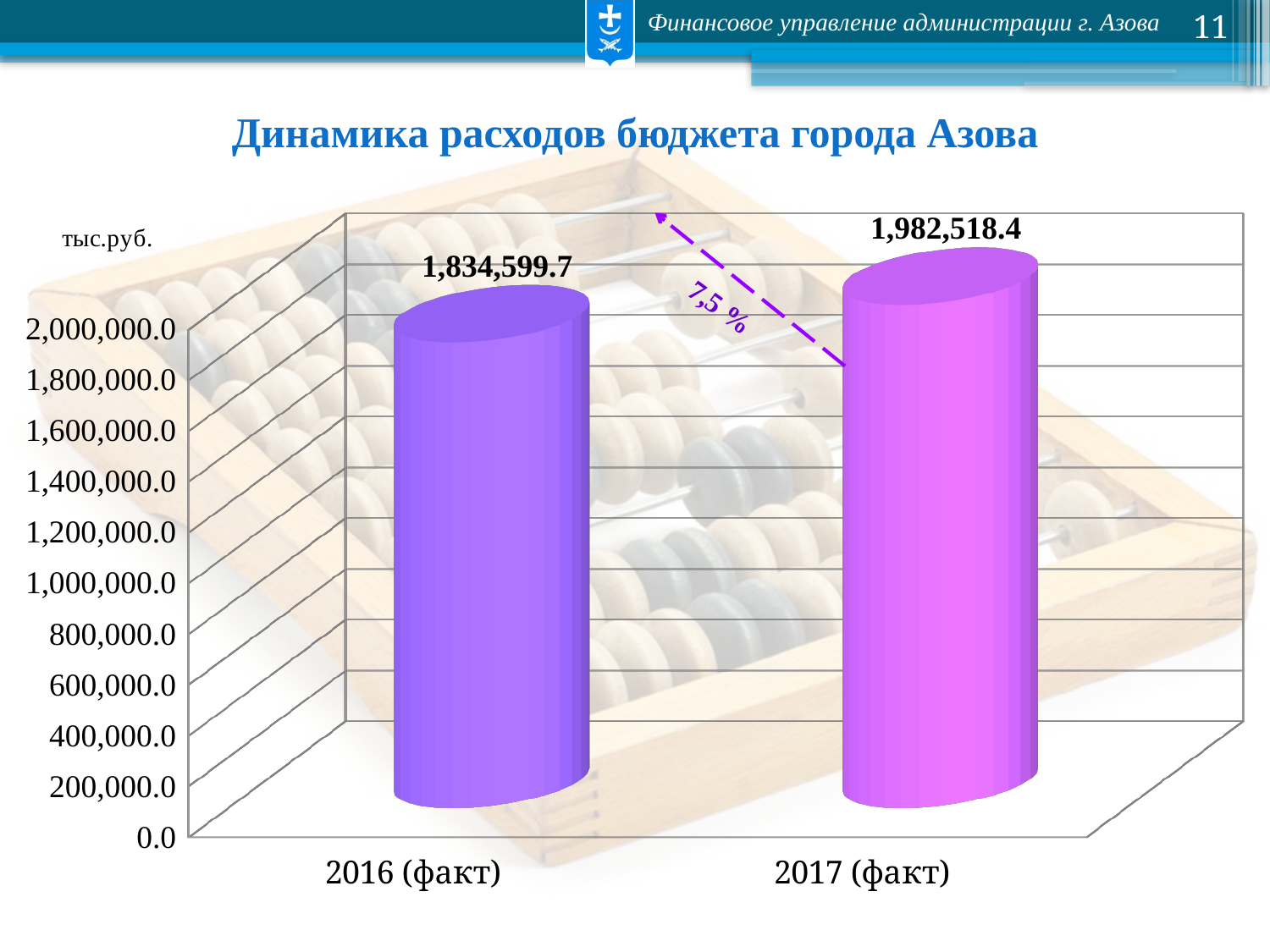
What is the value for 2017 (факт)? 1,982,518.4 Which category has the lowest value? 2016 (факт) Which is larger, the value for 2016 (факт) or the value for 2017 (факт)? 2017 (факт) What kind of chart is shown on the slide? bar chart Do the values rise or fall from 2016 (факт) to 2017 (факт)? rise What is the difference between the values for 2017 (факт) and 2016 (факт)? 147,918.7 What is the value for 2016 (факт)? 1,834,599.7 Which category has the highest value? 2017 (факт) Is the value for 2016 (факт) greater or less than 2,000,000.0? less What is the title of the chart? Динамика расходов бюджета города Азова What percentage change is annotated between the two bars? 7,5 % How many categories are shown on the x axis? 2